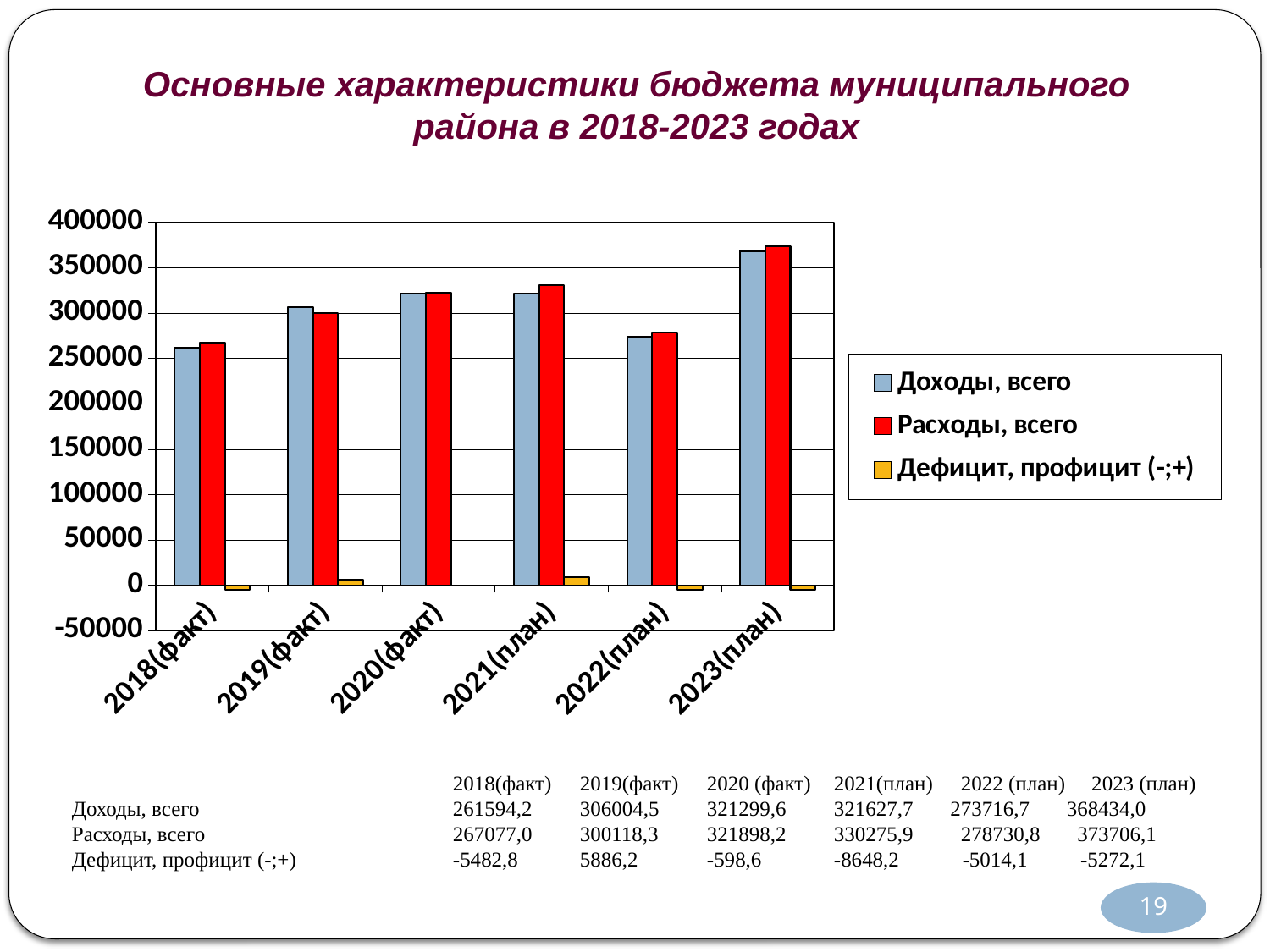
Is the value of Доходы, всего for 2022 (план) greater or less than 300000? less What is the difference between Расходы, всего and Доходы, всего in 2023 (план)? 5272,1 What is the value of Доходы, всего for 2023 (план)? 368434,0 How many years are shown on the x axis of the chart? 6 What kind of chart is shown on the slide? bar chart Which year has the highest value for Расходы, всего? 2023 (план) Which year has the lowest value for Доходы, всего? 2018 (факт) What is the value of Расходы, всего for 2021 (план)? 330275,9 Does Доходы, всего rise or fall from 2018 (факт) to 2020 (факт)? rise In 2019 (факт), which is larger: Доходы, всего or Расходы, всего? Доходы, всего What is the value of Дефицит, профицит (-;+) for 2019 (факт)? 5886,2 How many series does the legend list? 3